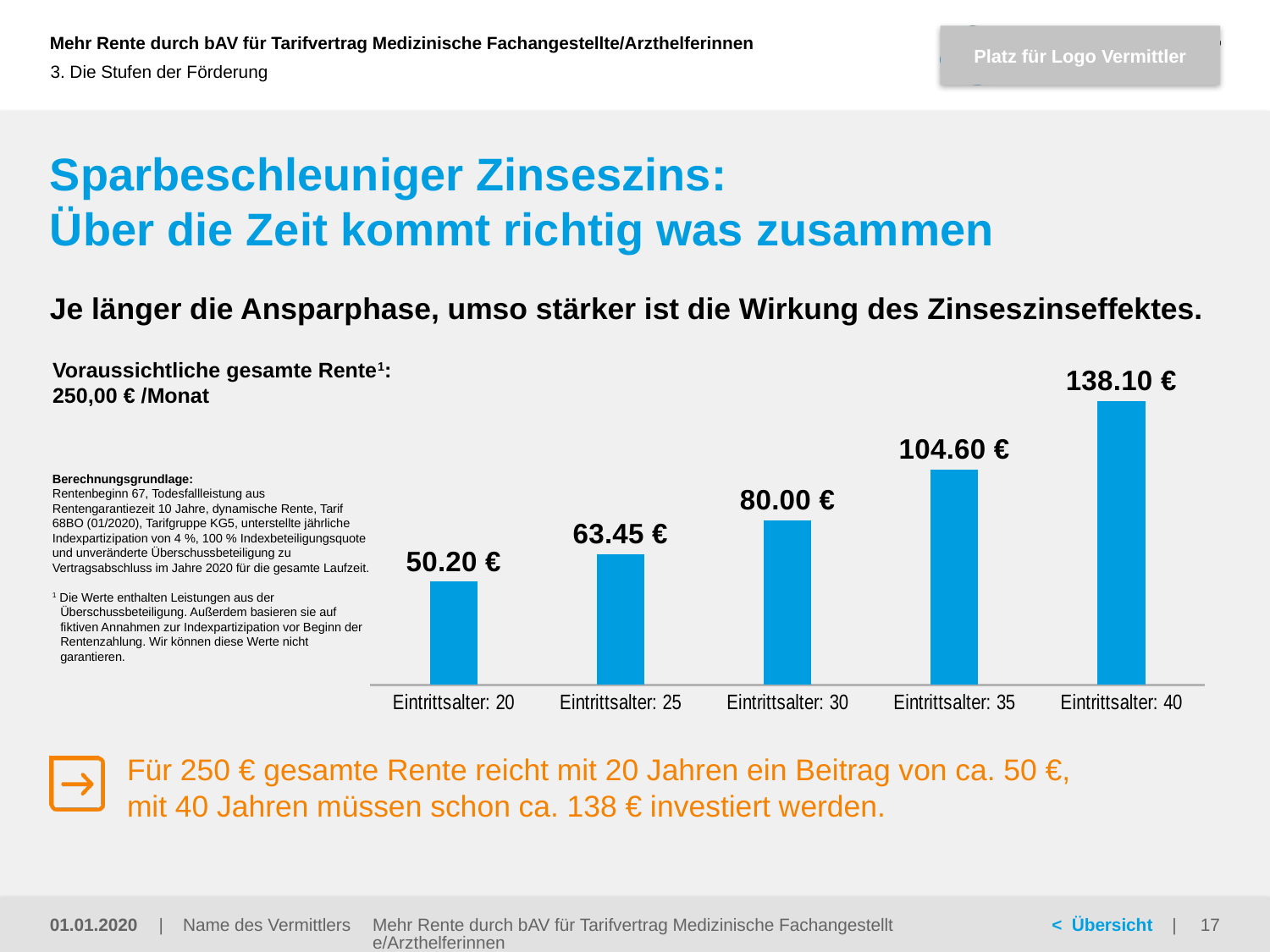
What is the value for Eintrittsalter: 20? 50.20 € What is the difference between the values for Eintrittsalter: 35 and Eintrittsalter: 30? 24.60 € What is the value for Eintrittsalter: 35? 104.60 € What kind of chart is shown on the slide? Bar chart Do the values rise or fall as the Eintrittsalter increases along the x axis? Rise Which is larger, the value for Eintrittsalter: 25 or the value for Eintrittsalter: 35? Eintrittsalter: 35 What is the difference between the values for Eintrittsalter: 40 and Eintrittsalter: 20? 87.90 € What is the value for Eintrittsalter: 30? 80.00 € What is the value for Eintrittsalter: 25? 63.45 € Which category has the highest value? Eintrittsalter: 40 How many categories are shown in the chart? 5 Which category has the lowest value? Eintrittsalter: 20